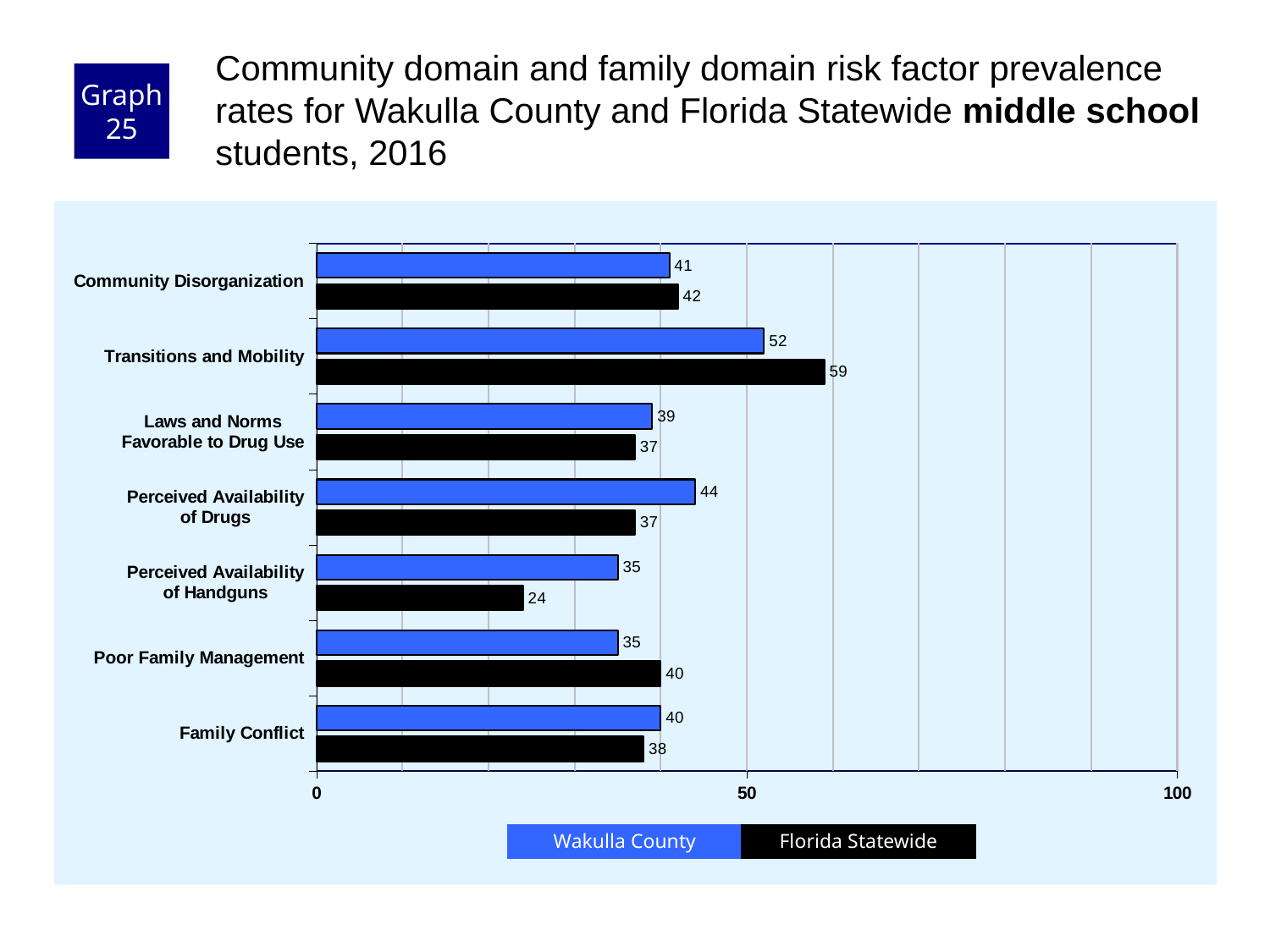
What is the Wakulla County value for Transitions and Mobility? 52 What is the difference between the Florida Statewide and Wakulla County values for Transitions and Mobility? 7 Which colour represents Florida Statewide in the chart? Black Which category has the lowest Florida Statewide value? Perceived Availability of Handguns How many risk factor categories are shown on the chart? 7 Which is larger for Perceived Availability of Drugs: the Wakulla County value or the Florida Statewide value? Wakulla County Which category has the highest Florida Statewide value? Transitions and Mobility What is the Florida Statewide value for Perceived Availability of Handguns? 24 What is the Wakulla County value for Family Conflict? 40 Is the Florida Statewide value for Transitions and Mobility greater or less than 50? greater How many series does the legend list? 2 What kind of chart is shown on the slide? Bar chart